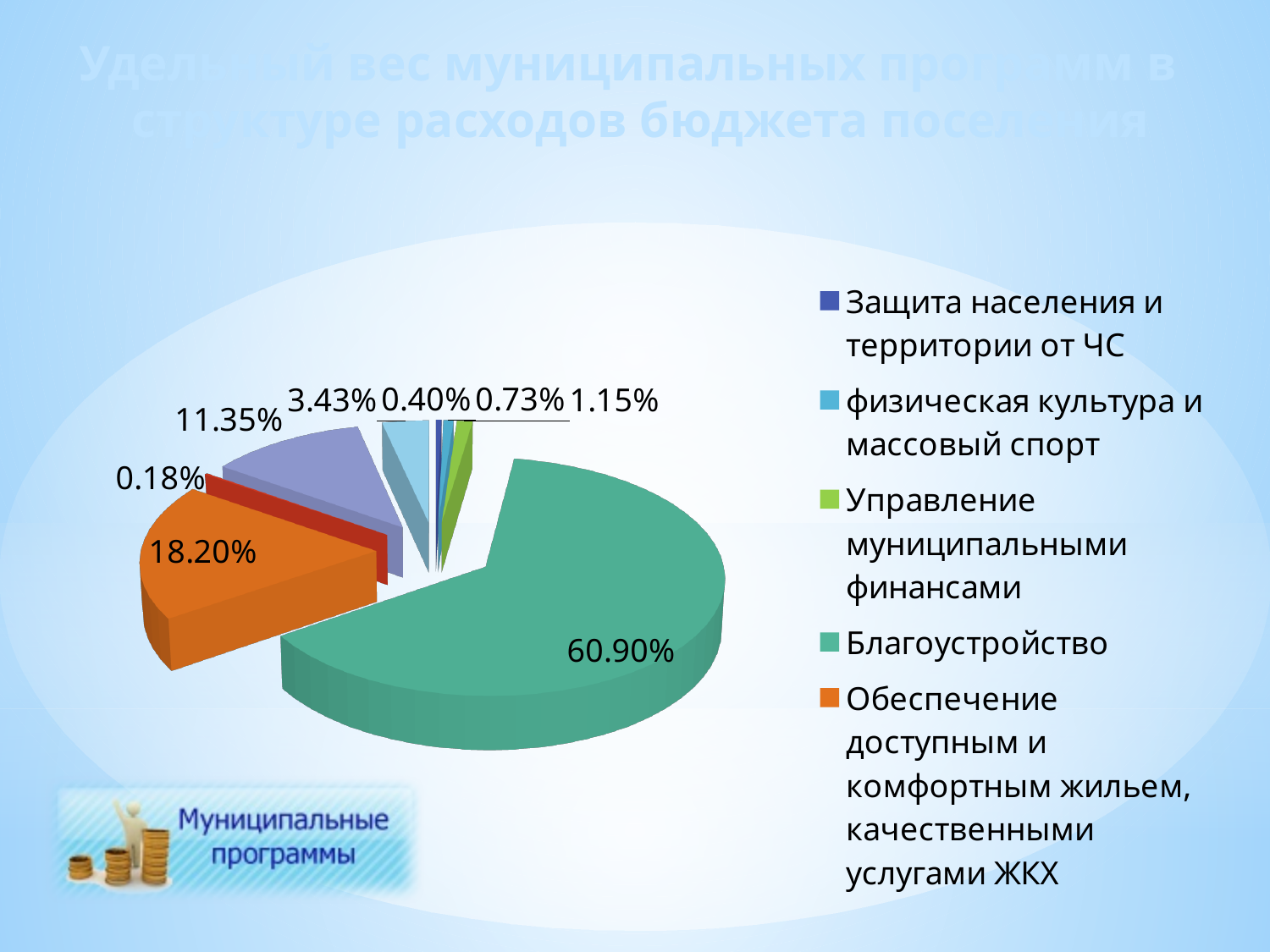
What is the difference between the Благоустройство slice and the Обеспечение доступным и комфортным жильем, качественными услугами ЖКХ slice? 42.70% Which category has the largest slice of the pie? Благоустройство What is the smallest percentage value labelled on the pie? 0.18% What kind of chart is shown on the slide? Pie chart What share of the pie does Благоустройство have? 60.90% How many slices are labelled with percentages on the pie? 8 Which is larger: the slice for Благоустройство or the slice for Обеспечение доступным и комфортным жильем, качественными услугами ЖКХ? Благоустройство What colour is the Благоустройство slice? Teal green How many entries are visible in the legend? 5 What is the value for Управление муниципальными финансами? 1.15% What is the value for Обеспечение доступным и комфортным жильем, качественными услугами ЖКХ? 18.20% What is the largest percentage value labelled on the pie? 60.90%